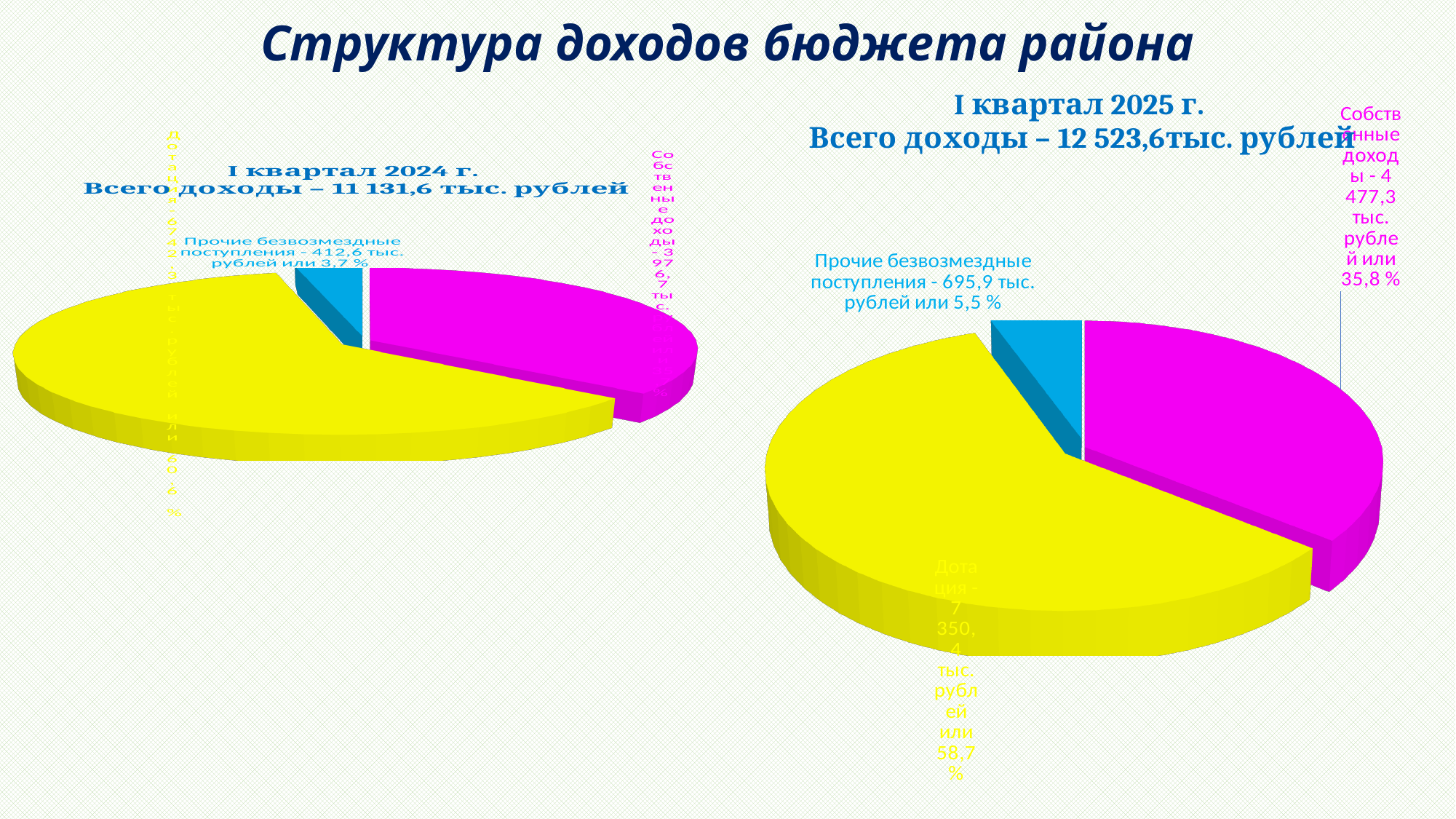
What is the difference between Прочие безвозмездные поступления in the I квартал 2025 г. chart (695,9 тыс. рублей) and in the I квартал 2024 г. chart (412,6 тыс. рублей)? 283,3 тыс. рублей What total income is stated in the title of the I квартал 2025 г. chart? 12 523,6 тыс. рублей In the I квартал 2025 г. pie chart, how many slices are there? 3 What kind of chart is used on the slide for the I квартал 2025 г. data? pie chart In the I квартал 2025 г. pie chart, what is the value for Собственные доходы? 4 477,3 тыс. рублей In the I квартал 2025 г. pie chart, which category has the smallest slice? Прочие безвозмездные поступления In the I квартал 2025 г. pie chart, what share of the pie is Собственные доходы? 35,8 % In the I квартал 2024 г. pie chart, what share of the pie is Прочие безвозмездные поступления? 3,7 % In the I квартал 2025 г. pie chart, which category has the largest slice? Дотация In the I квартал 2025 г. pie chart, what is the value for Прочие безвозмездные поступления? 695,9 тыс. рублей In the I квартал 2024 г. pie chart, what is the value for Прочие безвозмездные поступления? 412,6 тыс. рублей In the I квартал 2025 г. pie chart, what share of the pie is Дотация? 58,7 %